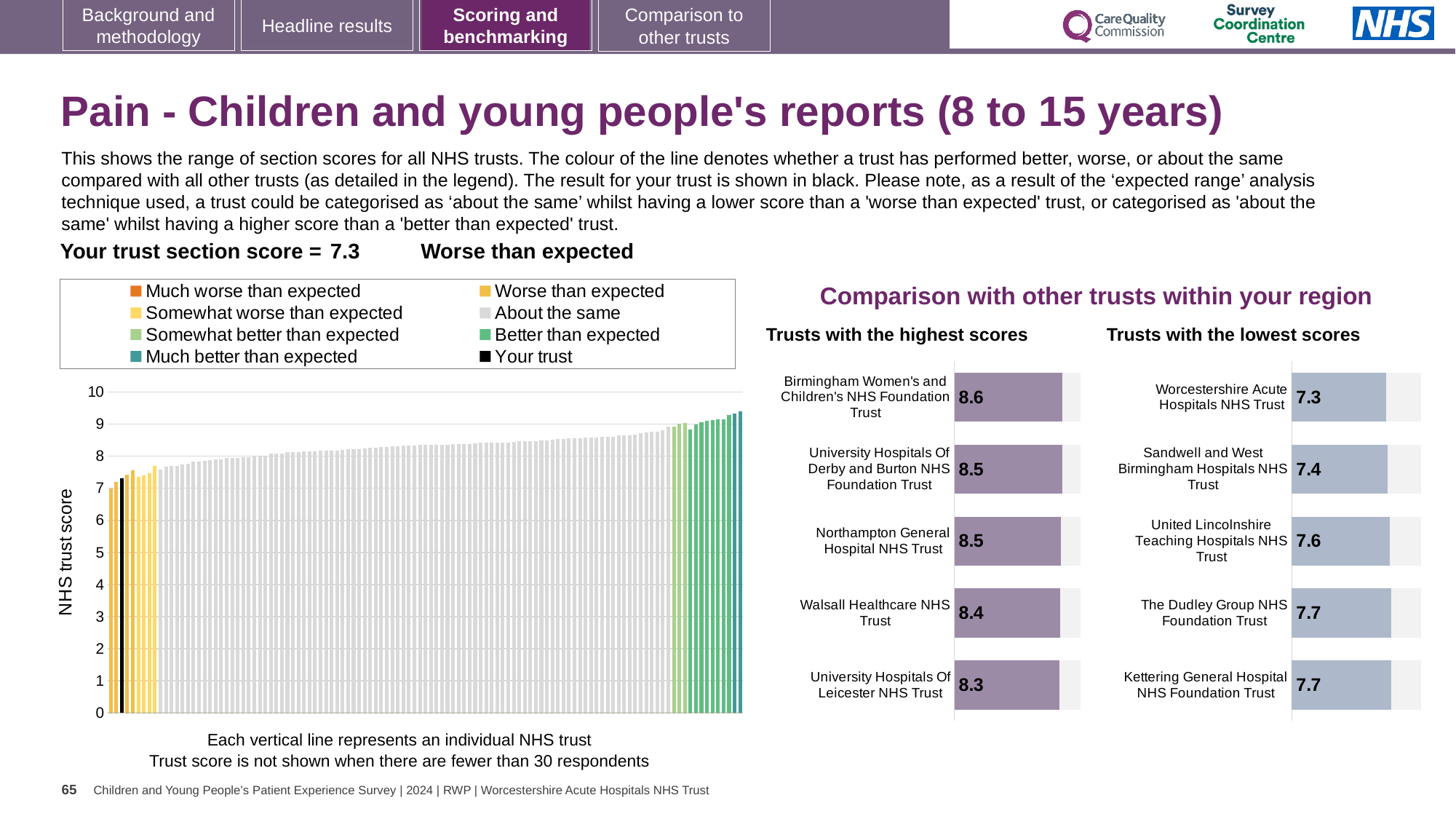
In the 'Trusts with the lowest scores' chart, what is the score for United Lincolnshire Teaching Hospitals NHS Trust? 7.6 In the 'Trusts with the highest scores' chart, what is the difference between the scores of Birmingham Women's and Children's NHS Foundation Trust and University Hospitals Of Leicester NHS Trust? 0.3 In the main 'NHS trust score' bar chart on the left, what is the section score for your trust? 7.3 In the 'Trusts with the lowest scores' chart, which trust has the lowest score? Worcestershire Acute Hospitals NHS Trust How many trusts are shown in the 'Trusts with the lowest scores' chart? 5 In the 'Trusts with the highest scores' chart, what is the score for Birmingham Women's and Children's NHS Foundation Trust? 8.6 In the 'Trusts with the highest scores' chart, which trust has the highest score? Birmingham Women's and Children's NHS Foundation Trust In the 'Trusts with the lowest scores' chart, how much higher is The Dudley Group NHS Foundation Trust's score than Worcestershire Acute Hospitals NHS Trust's score? 0.4 In the 'Trusts with the highest scores' chart, which has the higher score: Walsall Healthcare NHS Trust or Northampton General Hospital NHS Trust? Northampton General Hospital NHS Trust What kind of chart is the main 'NHS trust score' chart on the left? bar chart In the main 'NHS trust score' chart on the left, do the trust scores rise or fall from left to right? rise How many entries does the legend of the main 'NHS trust score' chart on the left list? 8